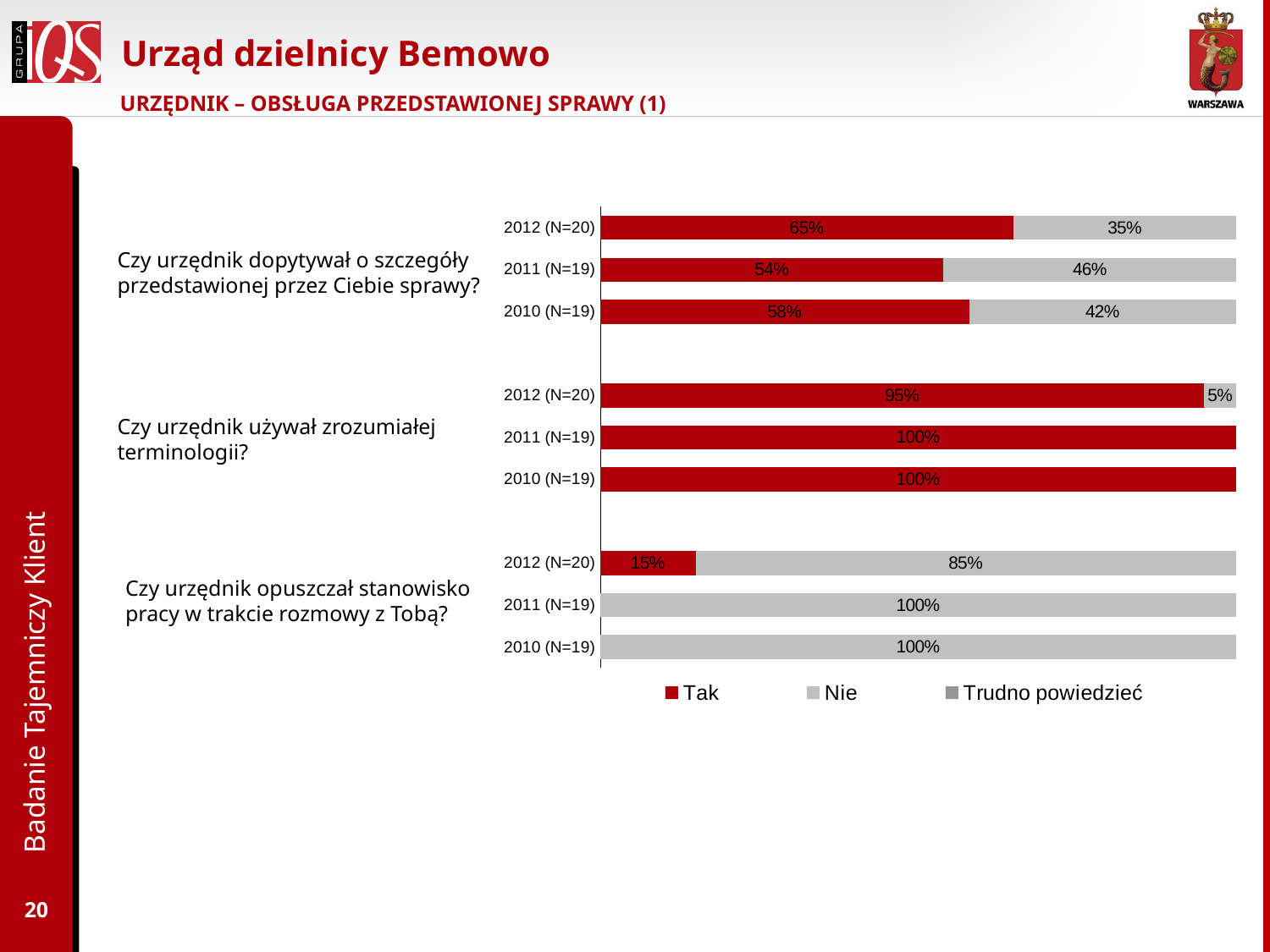
For the question 'Czy urzędnik używał zrozumiałej terminologii?', what is the 'Nie' value for 2012 (N=20)? 5% For the question 'Czy urzędnik używał zrozumiałej terminologii?', what is the 'Tak' value for 2011 (N=19)? 100% What type of chart is shown on the slide? Stacked bar chart For the question 'Czy urzędnik dopytywał o szczegóły przedstawionej przez Ciebie sprawy?', what is the 'Nie' value for 2011 (N=19)? 46% For the question 'Czy urzędnik dopytywał o szczegóły przedstawionej przez Ciebie sprawy?', which year has the lowest 'Tak' share? 2011 (N=19) What are the legend entries of the chart? Tak, Nie, Trudno powiedzieć For the question 'Czy urzędnik dopytywał o szczegóły przedstawionej przez Ciebie sprawy?', what is the 'Tak' value for 2012 (N=20)? 65% For the question 'Czy urzędnik dopytywał o szczegóły przedstawionej przez Ciebie sprawy?', what is the difference between the 'Tak' values for 2012 (N=20) and 2010 (N=19)? 7 percentage points How many series does the chart legend list? 3 For the question 'Czy urzędnik opuszczał stanowisko pracy w trakcie rozmowy z Tobą?', what is the 'Tak' value for 2012 (N=20)? 15% For the question 'Czy urzędnik opuszczał stanowisko pracy w trakcie rozmowy z Tobą?', is the 'Nie' value for 2012 (N=20) larger or smaller than the 'Tak' value? Larger For the question 'Czy urzędnik dopytywał o szczegóły przedstawionej przez Ciebie sprawy?', which year has the highest 'Tak' share? 2012 (N=20)